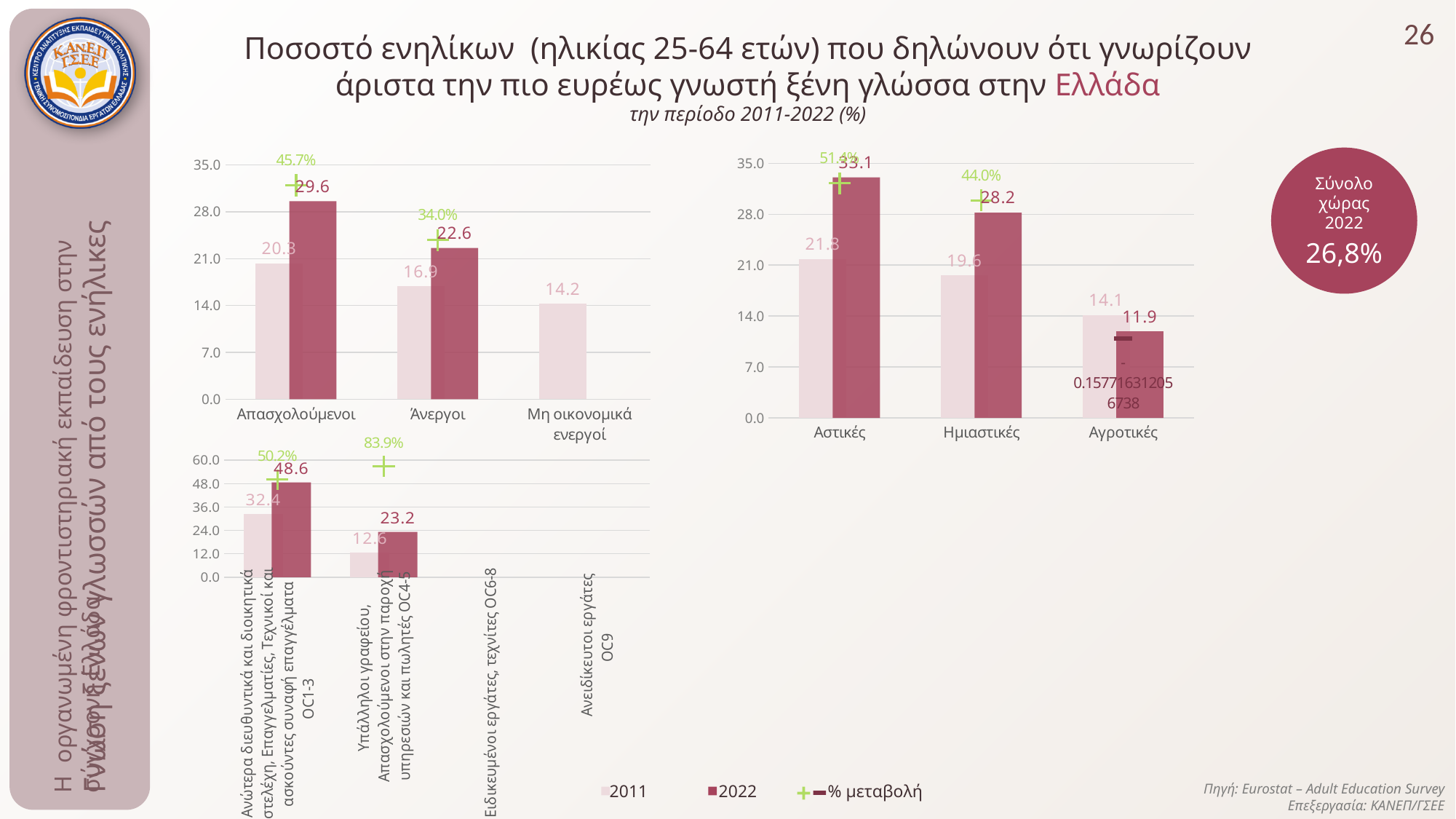
In the right-hand chart, what percentage change is shown for Ημιαστικές? 44.0% In the top-left chart, what percentage change is shown for Άνεργοι? 34.0% In the right-hand chart, what is the 2022 value for Ημιαστικές? 28.2 How many series does the legend at the bottom of the slide list? 3 In the right-hand chart, is the 2011 value for Αγροτικές larger or smaller than its 2022 value? larger In the bottom-left chart, what percentage change is shown for the OC4-5 category? 83.9% In the top-left chart, what is the difference between the 2022 and 2011 values for Απασχολούμενοι? 9.3 In the right-hand chart, which category has the highest 2022 value? Αστικές In the top-left chart, what is the 2011 value for Άνεργοι? 16.9 What type of chart is the right-hand chart? bar chart In the top-left chart, what is the 2022 value for Απασχολούμενοι? 29.6 In the bottom-left chart, what is the 2022 value for the OC1-3 category? 48.6